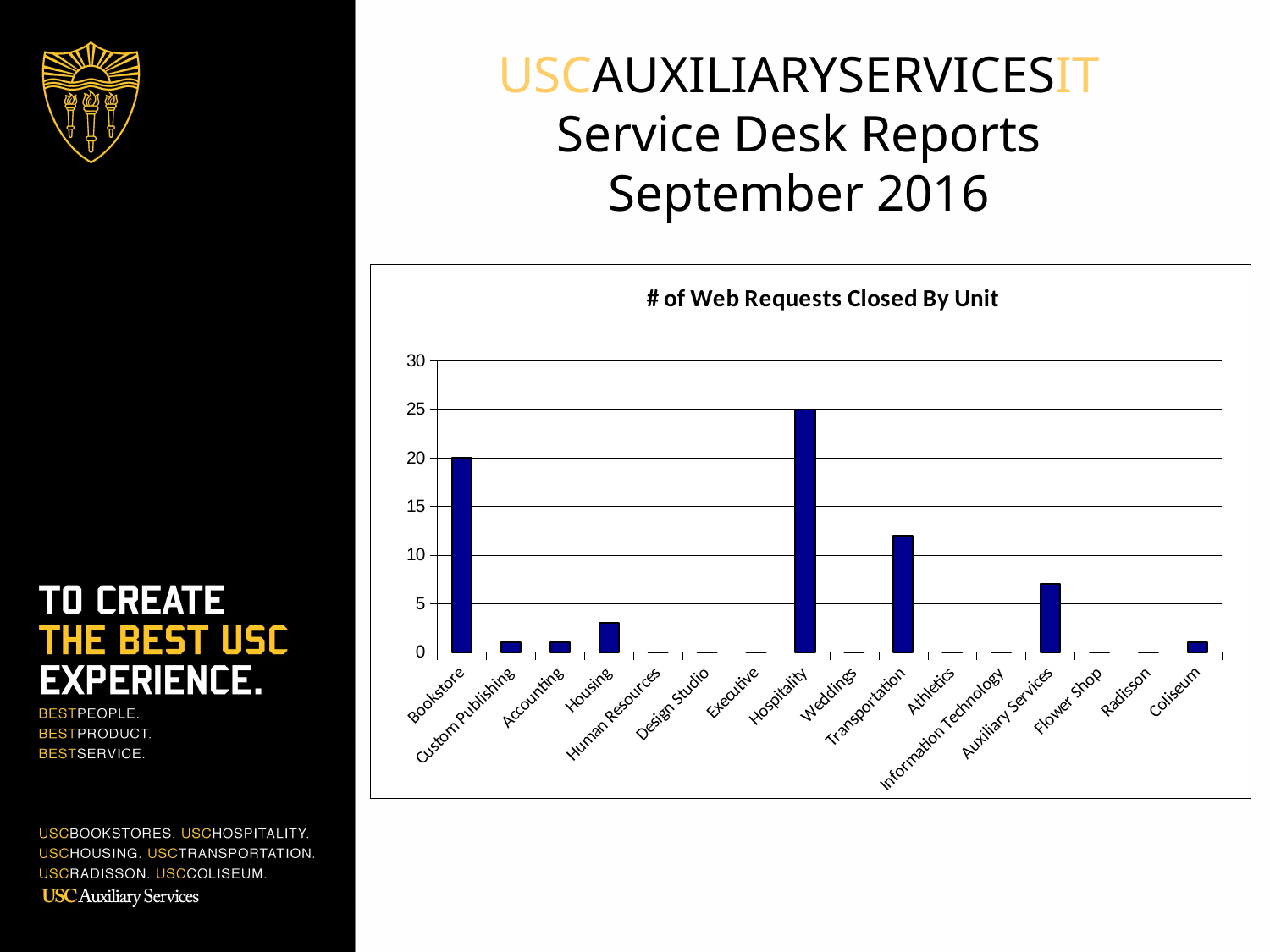
Which unit has the highest number of web requests closed? Hospitality What is the title of the chart? # of Web Requests Closed By Unit What colour are the bars in the chart? blue How many web requests were closed by Bookstore? 20 Is the value for Transportation greater or less than 10? greater What kind of chart is shown on the slide? bar chart How many web requests were closed by Hospitality? 25 Which unit closed more web requests, Bookstore or Transportation? Bookstore Is the value for Auxiliary Services greater or less than 5? greater What is the difference between the number of web requests closed by Hospitality and by Bookstore? 5 How many units (categories) are shown on the x axis of the chart? 16 Is the value for Housing greater or less than 5? less